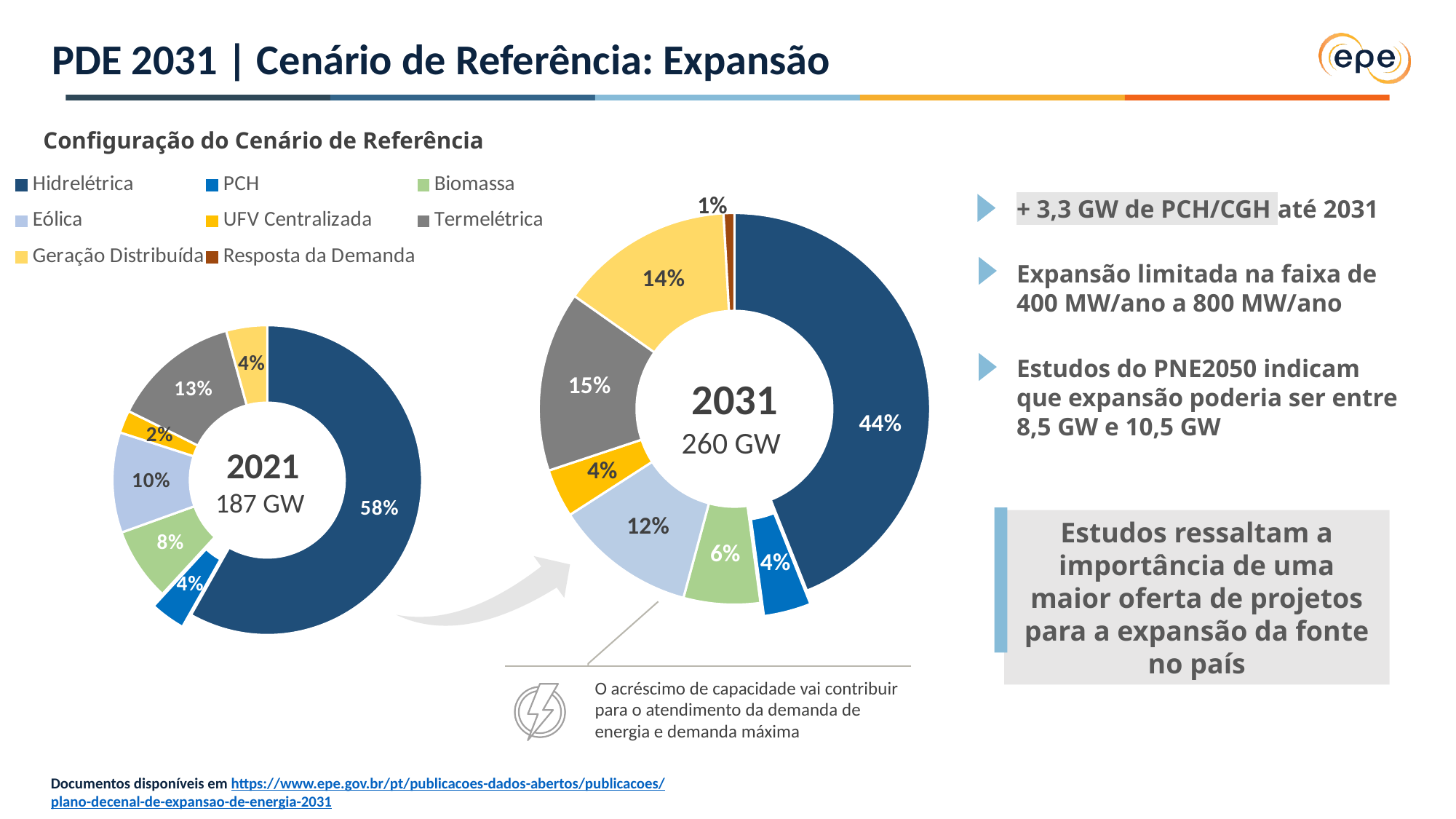
In the 2021 donut chart, what share does Hidrelétrica have? 58% What type of chart is used to show the 2021 and 2031 configurations? Donut (pie) chart In the 2031 donut chart, what share does Termelétrica have? 15% In the 2031 donut chart, which source has the smallest share? Resposta da Demanda How many slices does the 2031 donut chart have? 8 In the 2021 donut chart, which source has the largest share? Hidrelétrica In the 2031 donut chart, what share does Hidrelétrica have? 44% What is the difference between the Hidrelétrica share in the 2021 chart and in the 2031 chart? 14 percentage points In the 2031 donut chart, which is larger: the share of Eólica or the share of Biomassa? Eólica In the 2021 donut chart, what share does Eólica have? 10% In the 2031 donut chart, what share does Geração Distribuída have? 14% What total capacity is shown in the centre of the 2031 donut chart? 260 GW